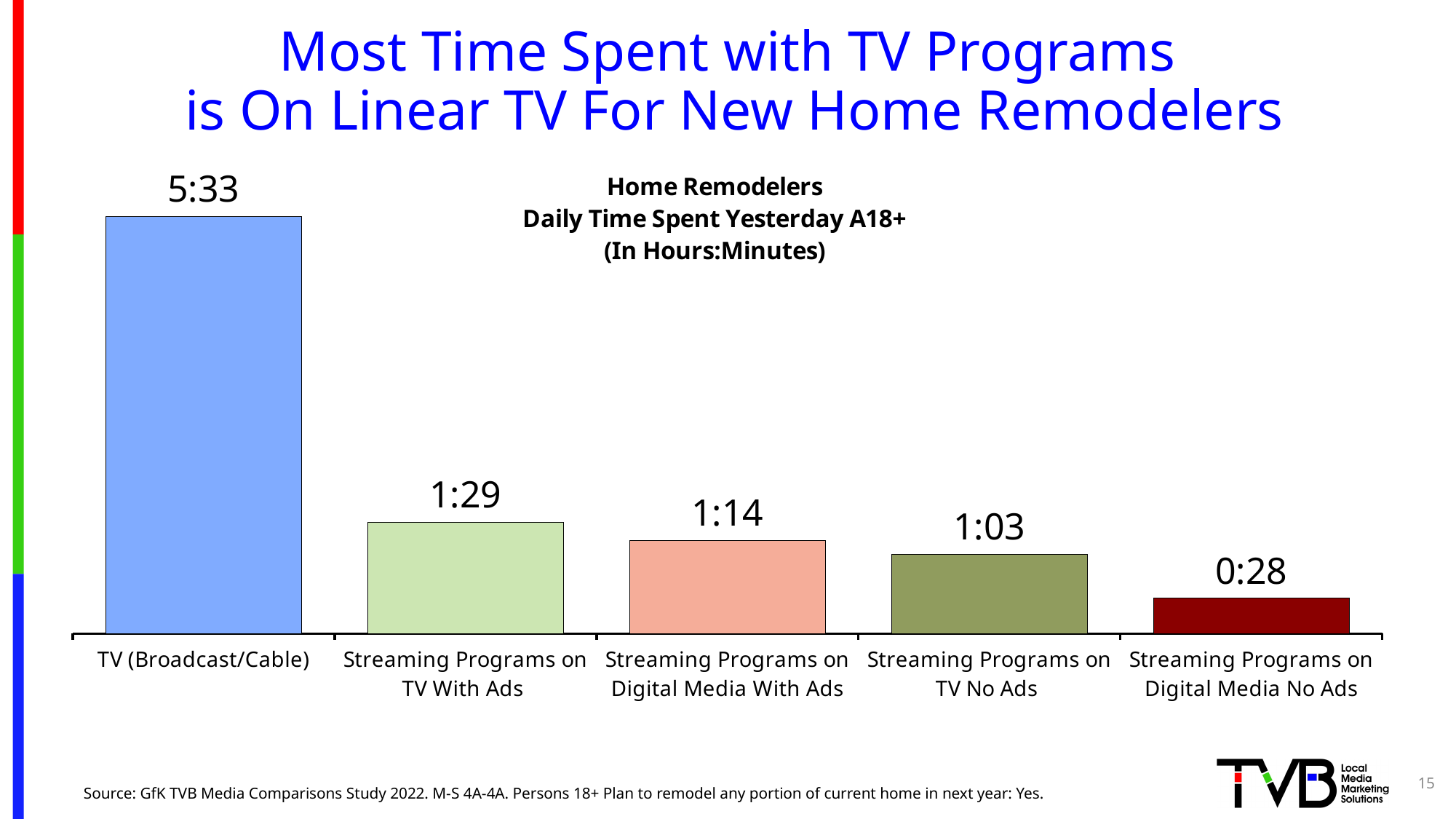
What is the daily time spent for TV (Broadcast/Cable)? 5:33 How many categories are shown in the chart? 5 What is the title of the chart? Home Remodelers Daily Time Spent Yesterday A18+ (In Hours:Minutes) What is the daily time spent for Streaming Programs on Digital Media No Ads? 0:28 Which category has the lowest daily time spent? Streaming Programs on Digital Media No Ads What is the daily time spent for Streaming Programs on Digital Media With Ads? 1:14 Which category has the highest daily time spent? TV (Broadcast/Cable) What is the daily time spent for Streaming Programs on TV No Ads? 1:03 What is the daily time spent for Streaming Programs on TV With Ads? 1:29 What kind of chart is shown on the slide? Bar chart Do the values rise or fall moving from left to right across the categories? Fall Which is larger: the time spent for Streaming Programs on TV With Ads or for Streaming Programs on TV No Ads? Streaming Programs on TV With Ads